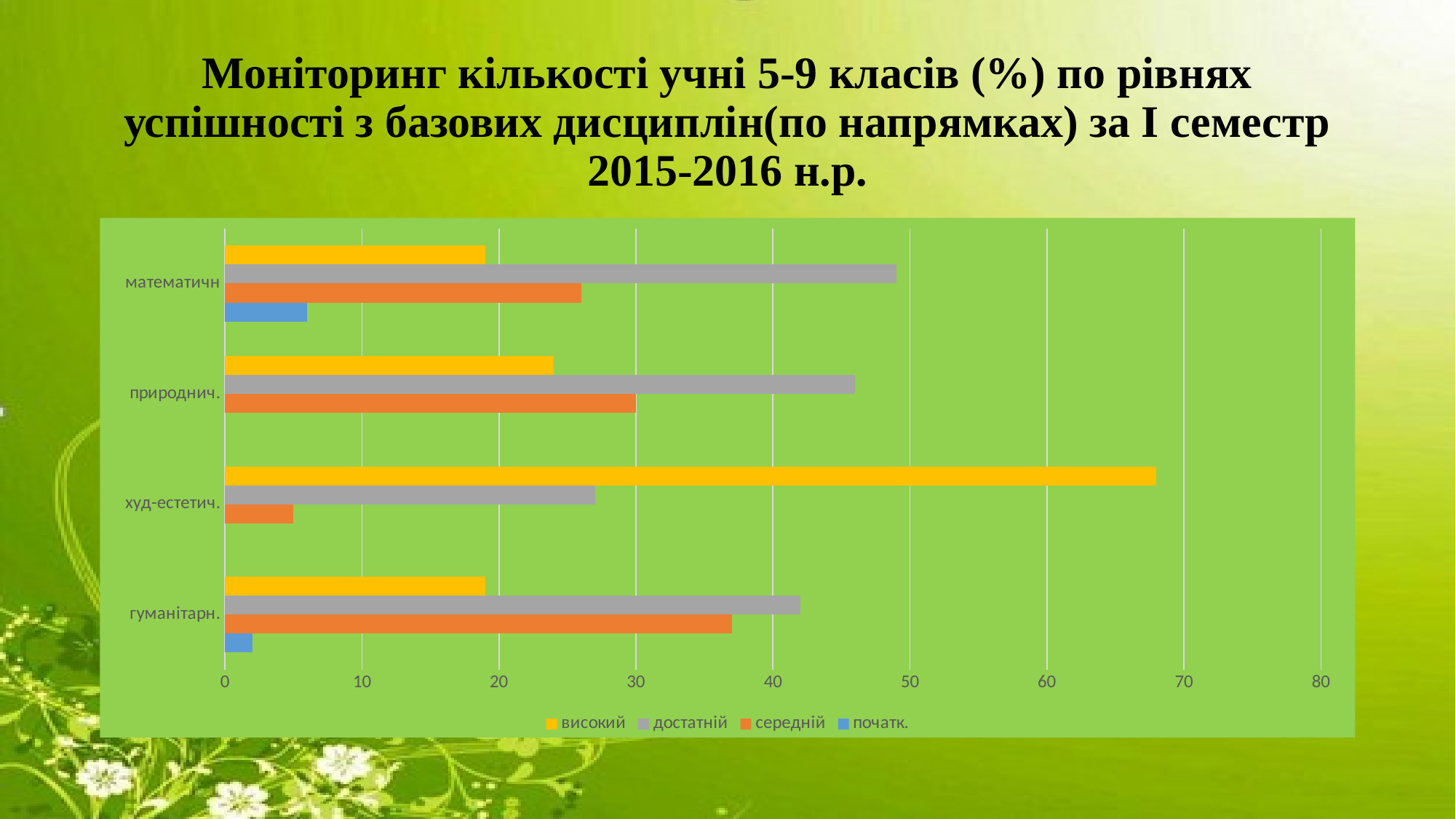
Is the початк. value for математичн greater or less than 10? less Is the середній value for гуманітарн. greater or less than 30? greater Which has the larger високий value: природнич. or математичн? природнич. Which category has the lowest value for the середній series? худ-естетич. How many categories are plotted on the vertical axis? 4 Which category has the highest value for the високий series? худ-естетич. For гуманітарн., which is larger: the достатній value or the середній value? достатній Is the високий value for худ-естетич. greater or less than 60? greater Which series is listed first in the legend? високий How many series does the legend list? 4 What kind of chart is shown on the slide? bar chart